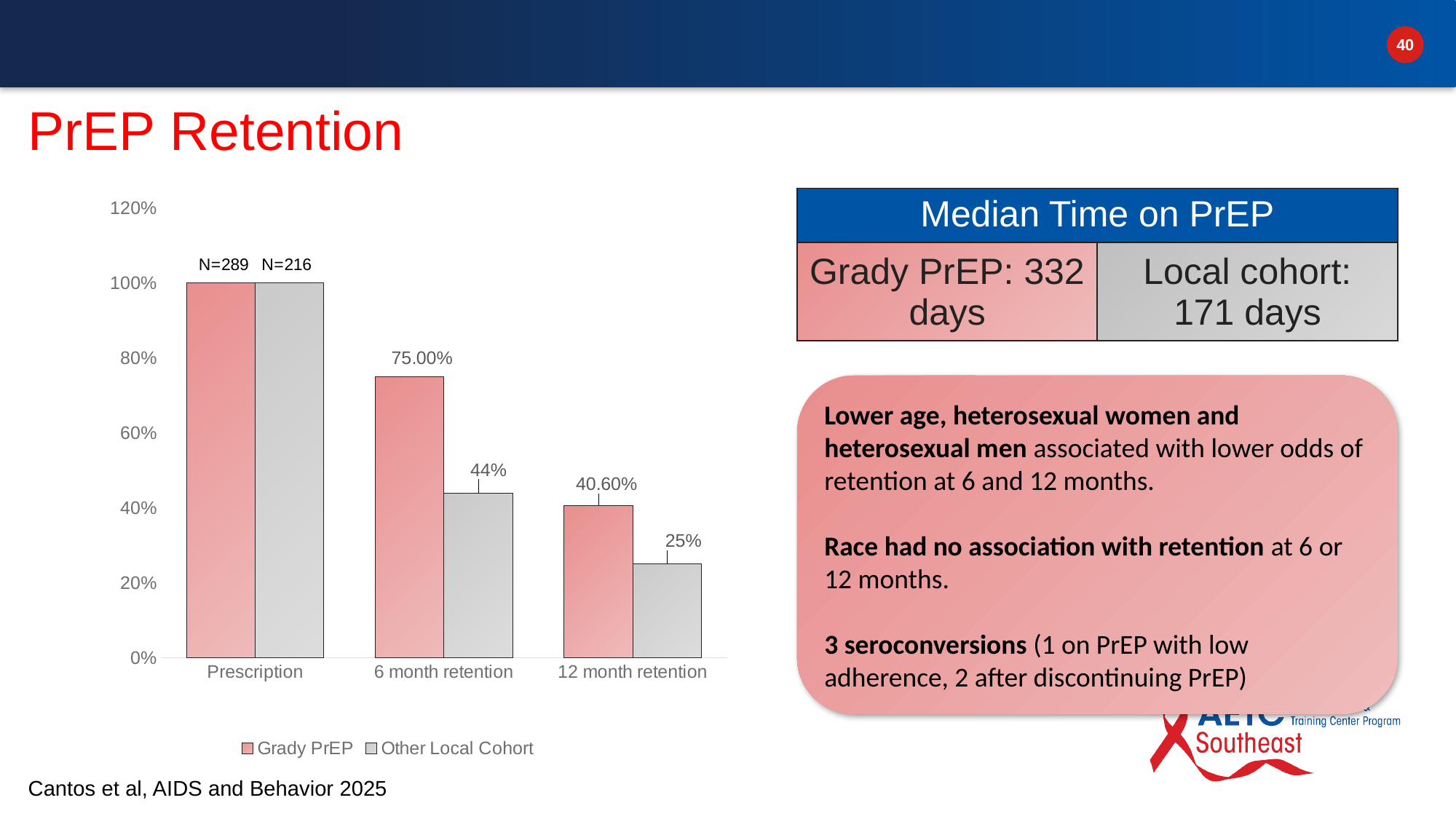
How many series does the chart legend list? 2 Which category has the lowest value for Other Local Cohort? 12 month retention At 6 month retention, which series has the larger value, Grady PrEP or Other Local Cohort? Grady PrEP What is the difference between the Grady PrEP and Other Local Cohort values at 12 month retention? 15.60% What is the 12 month retention value for Other Local Cohort? 25% What is the N shown above the Grady PrEP Prescription bar? N=289 Do the Grady PrEP values rise or fall from Prescription to 12 month retention? Fall What is the 6 month retention value for Grady PrEP? 75.00% What is the 6 month retention value for Other Local Cohort? 44% What is the 12 month retention value for Grady PrEP? 40.60% How many categories are shown on the x axis of the chart? 3 What kind of chart is shown on the slide? Bar chart